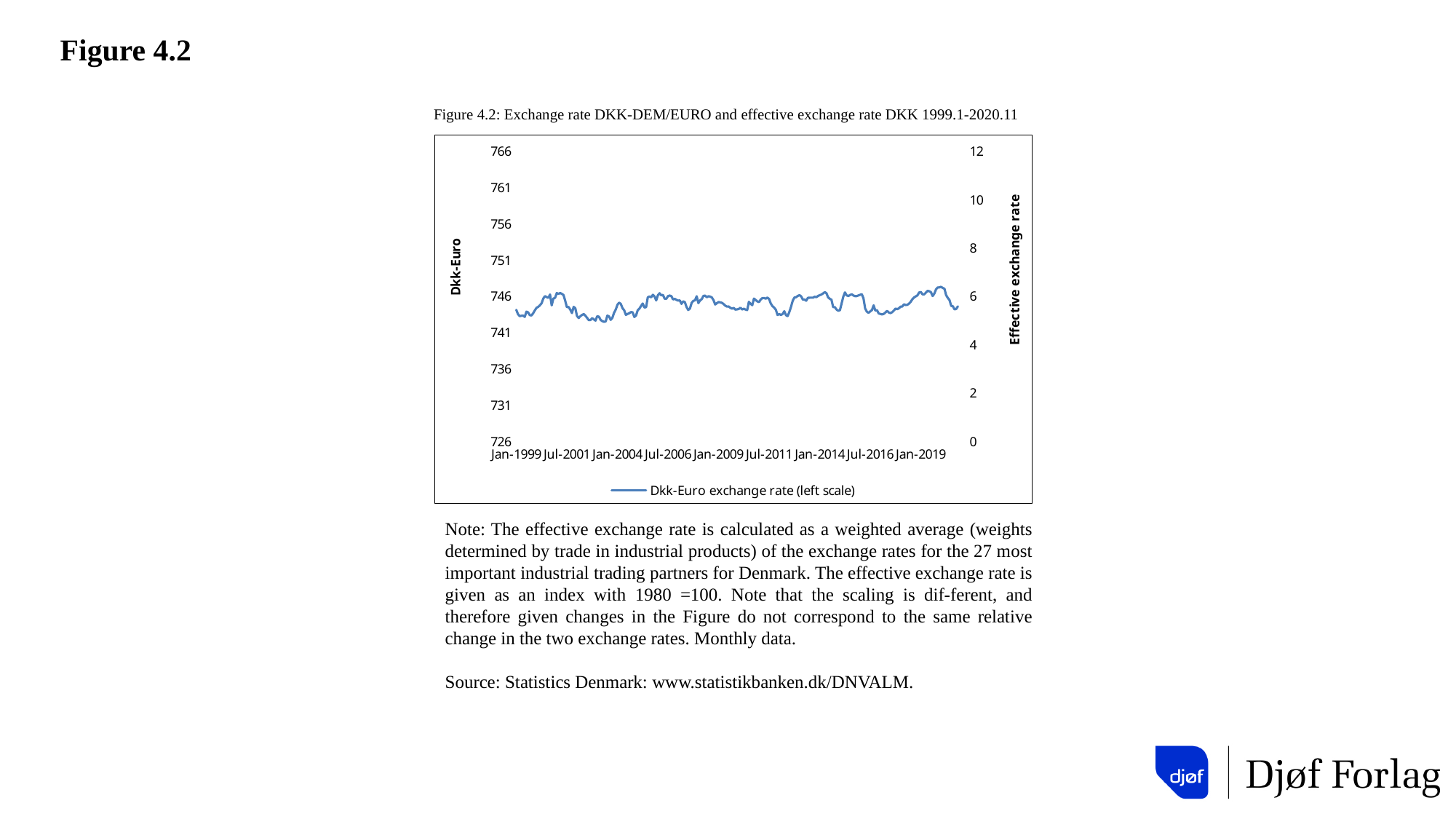
How many date labels are shown along the x axis? 9 What is the highest tick value shown on the left (Dkk-Euro) axis? 766 What is the first date label on the x axis? Jan-1999 Does the Dkk-Euro exchange rate line ever go above 751 on the left axis? No What is the legend entry for the plotted line? Dkk-Euro exchange rate (left scale) Is the Dkk-Euro exchange rate at Jan-1999 greater or less than 741? greater Does the Dkk-Euro exchange rate line ever fall below 736 on the left axis? No What kind of chart is shown in Figure 4.2? Line chart How many series does the legend of the chart list? 1